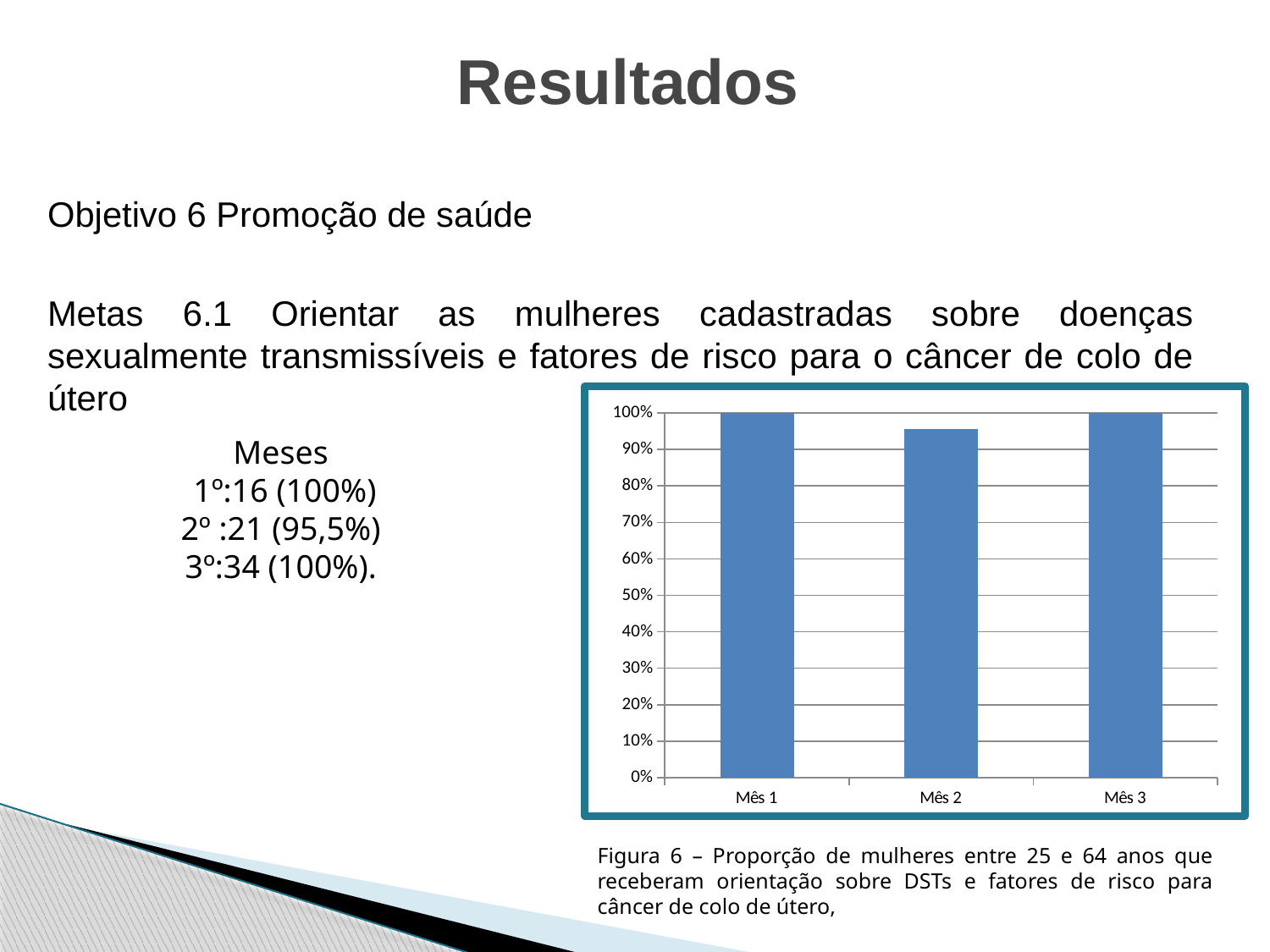
Which month has the lowest bar? Mês 2 Is the value for Mês 2 greater or less than 90%? greater What is the value for Mês 3? 100% Which is larger, the value for Mês 3 or the value for Mês 2? Mês 3 Which is larger, the value for Mês 1 or the value for Mês 2? Mês 1 Is the value for Mês 2 greater or less than 100%? less Do the values fall or rise from Mês 1 to Mês 2? fall How many categories (months) are plotted on the chart? 3 What is the value for Mês 1? 100% What kind of chart is shown on the slide? bar chart What colour are the bars in the chart? blue What is the highest tick value shown on the vertical axis? 100%